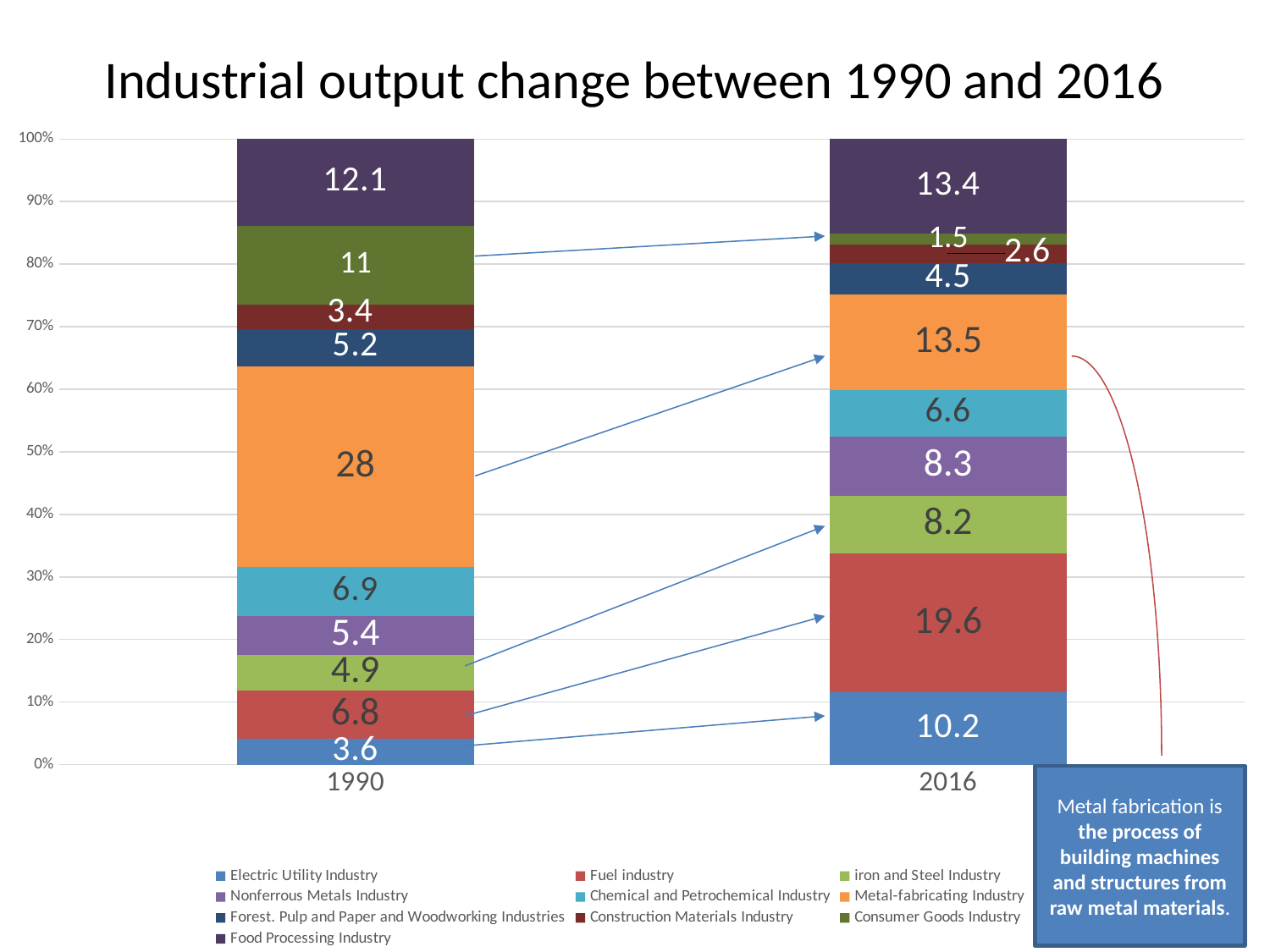
What is the value for the Metal-fabricating Industry in 1990? 28 What is the value for the Fuel industry in 2016? 19.6 Which industry has the largest segment in the 1990 bar? Metal-fabricating Industry Is the Chemical and Petrochemical Industry value larger in 1990 or in 2016? 1990 How many series does the legend list? 10 Which industry has the smallest segment in the 2016 bar? Consumer Goods Industry By how much did the Metal-fabricating Industry value fall from 1990 to 2016? 14.5 Which industry has the largest segment in the 2016 bar? Fuel industry What is the value for the Consumer Goods Industry in 1990? 11 What is the difference between the Electric Utility Industry values in 2016 and 1990? 6.6 What kind of chart is shown on the slide? Stacked bar chart What is the value for the Food Processing Industry in 2016? 13.4